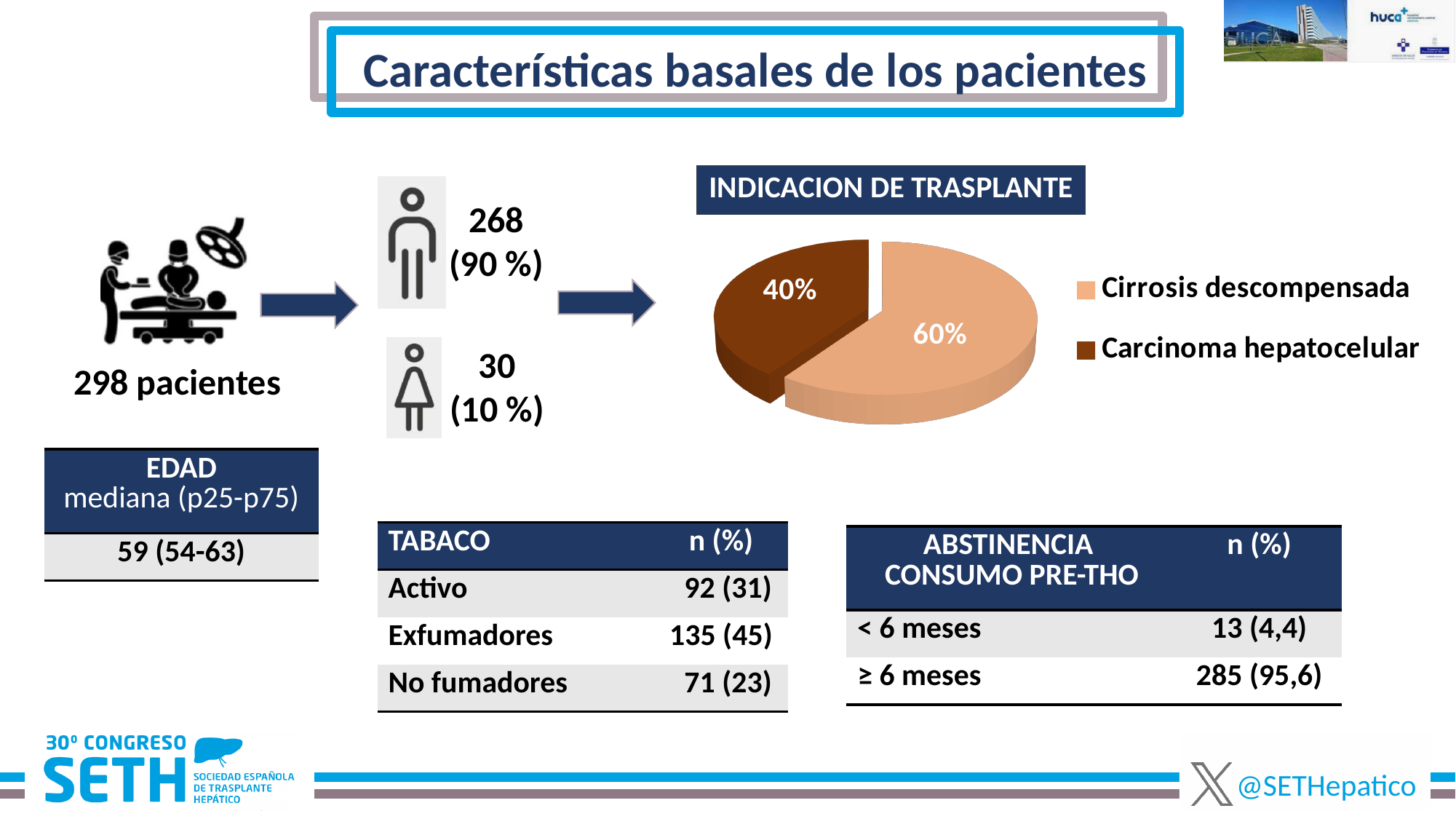
In the 'INDICACION DE TRASPLANTE' pie chart, what share is labelled for Cirrosis descompensada? 60% In the 'INDICACION DE TRASPLANTE' pie chart, which slice is the largest? Cirrosis descompensada In the 'INDICACION DE TRASPLANTE' pie chart, what share is labelled for Carcinoma hepatocelular? 40% In the 'INDICACION DE TRASPLANTE' pie chart, which slice is the smallest? Carcinoma hepatocelular In the 'INDICACION DE TRASPLANTE' pie chart, which legend entry is shown in dark brown? Carcinoma hepatocelular How many slices does the 'INDICACION DE TRASPLANTE' pie chart have? 2 How many entries does the legend of the 'INDICACION DE TRASPLANTE' pie chart list? 2 What is the title of the pie chart on the slide? INDICACION DE TRASPLANTE In the 'INDICACION DE TRASPLANTE' pie chart, what is the difference in percentage points between Cirrosis descompensada and Carcinoma hepatocelular? 20% What kind of chart is shown under the title 'INDICACION DE TRASPLANTE'? pie chart In the 'INDICACION DE TRASPLANTE' pie chart, which is larger: Cirrosis descompensada or Carcinoma hepatocelular? Cirrosis descompensada